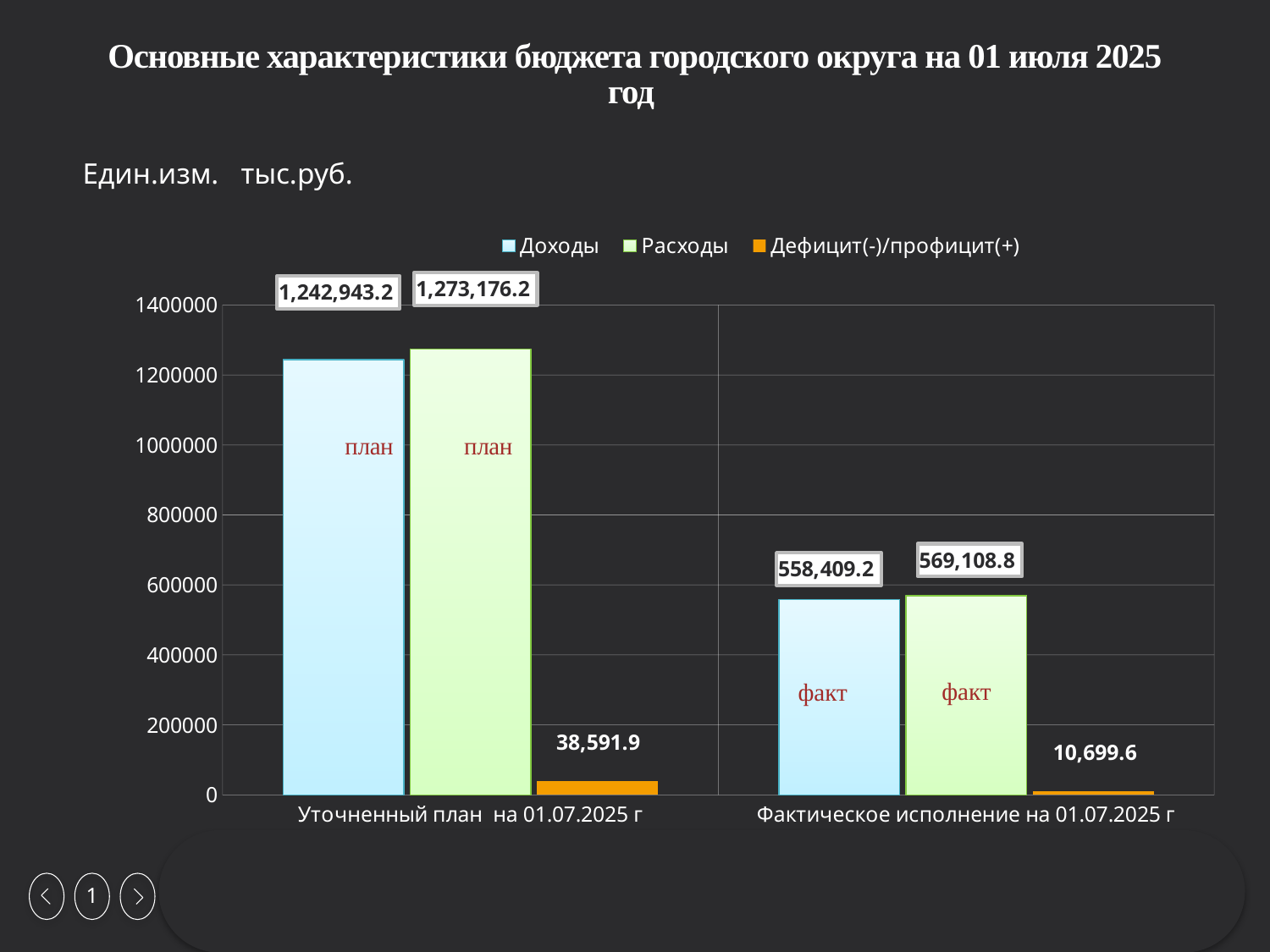
Which series has the highest value in the Уточненный план на 01.07.2025 г category? Расходы Is the Доходы value for Фактическое исполнение на 01.07.2025 г greater or less than 600000? less Which series has the lowest value in the Фактическое исполнение на 01.07.2025 г category? Дефицит(-)/профицит(+) What is the value of Расходы for Фактическое исполнение на 01.07.2025 г? 569,108.8 What is the value of Дефицит(-)/профицит(+) for Фактическое исполнение на 01.07.2025 г? 10,699.6 How many categories are shown on the x axis? 2 What type of chart is shown on the slide? bar chart What is the difference between Расходы and Доходы for Уточненный план на 01.07.2025 г? 30,233.0 What is the value of Расходы for Уточненный план на 01.07.2025 г? 1,273,176.2 How many series does the legend list? 3 What is the value of Доходы for Уточненный план на 01.07.2025 г? 1,242,943.2 What unit of measurement is stated on the slide for the chart values? тыс.руб.